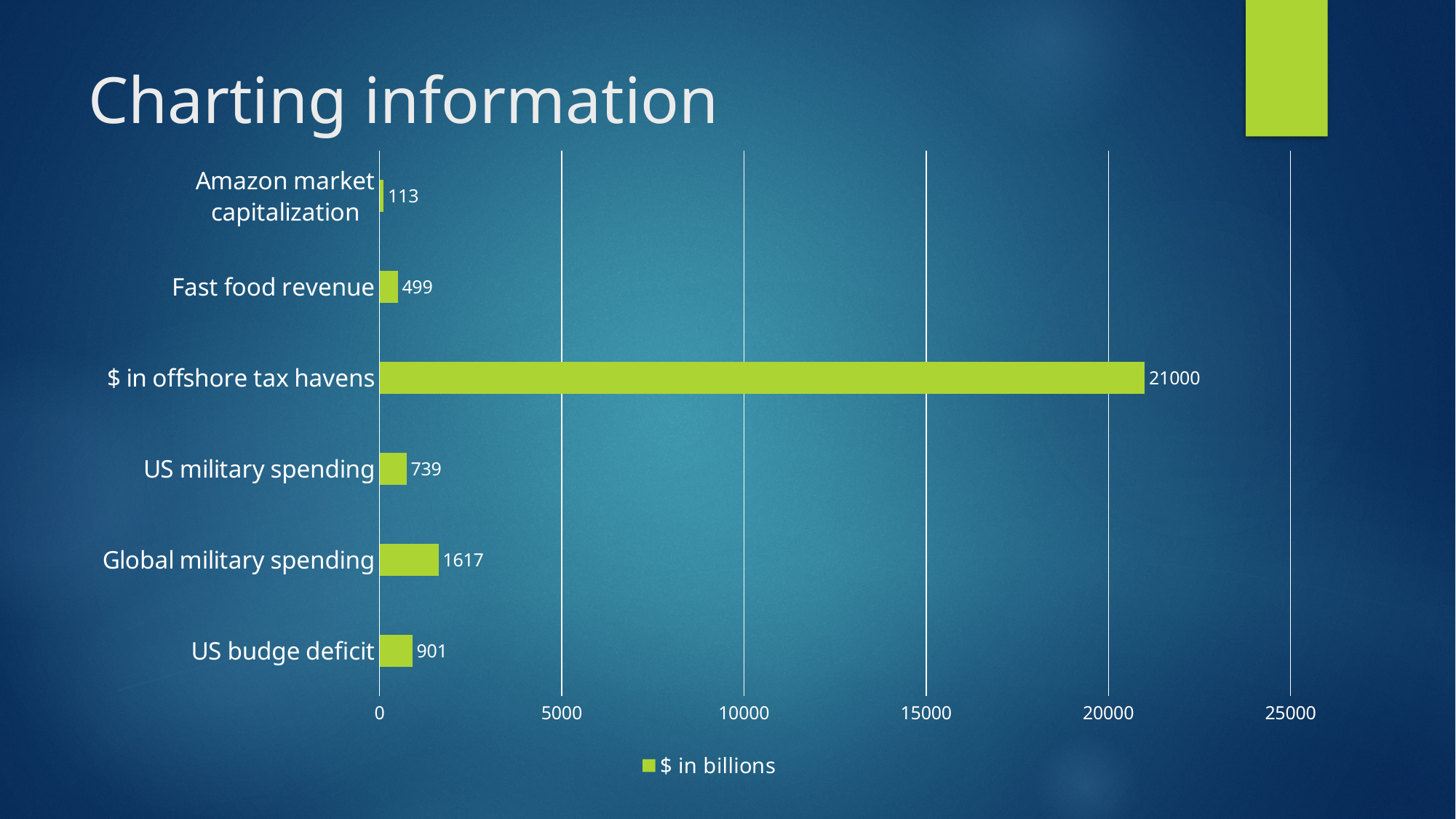
Is the value for $ in offshore tax havens greater or less than 20000? greater What is the value for US military spending? 739 What is the value for $ in offshore tax havens? 21000 What series name does the legend show? $ in billions Which is larger, US budge deficit or Fast food revenue? US budge deficit How many categories are shown in the chart? 6 What is the difference between Global military spending and US military spending? 878 Which category has the highest value? $ in offshore tax havens What kind of chart is shown on the slide? Bar chart What is the value for Amazon market capitalization? 113 What is the value for Global military spending? 1617 Which category has the lowest value? Amazon market capitalization